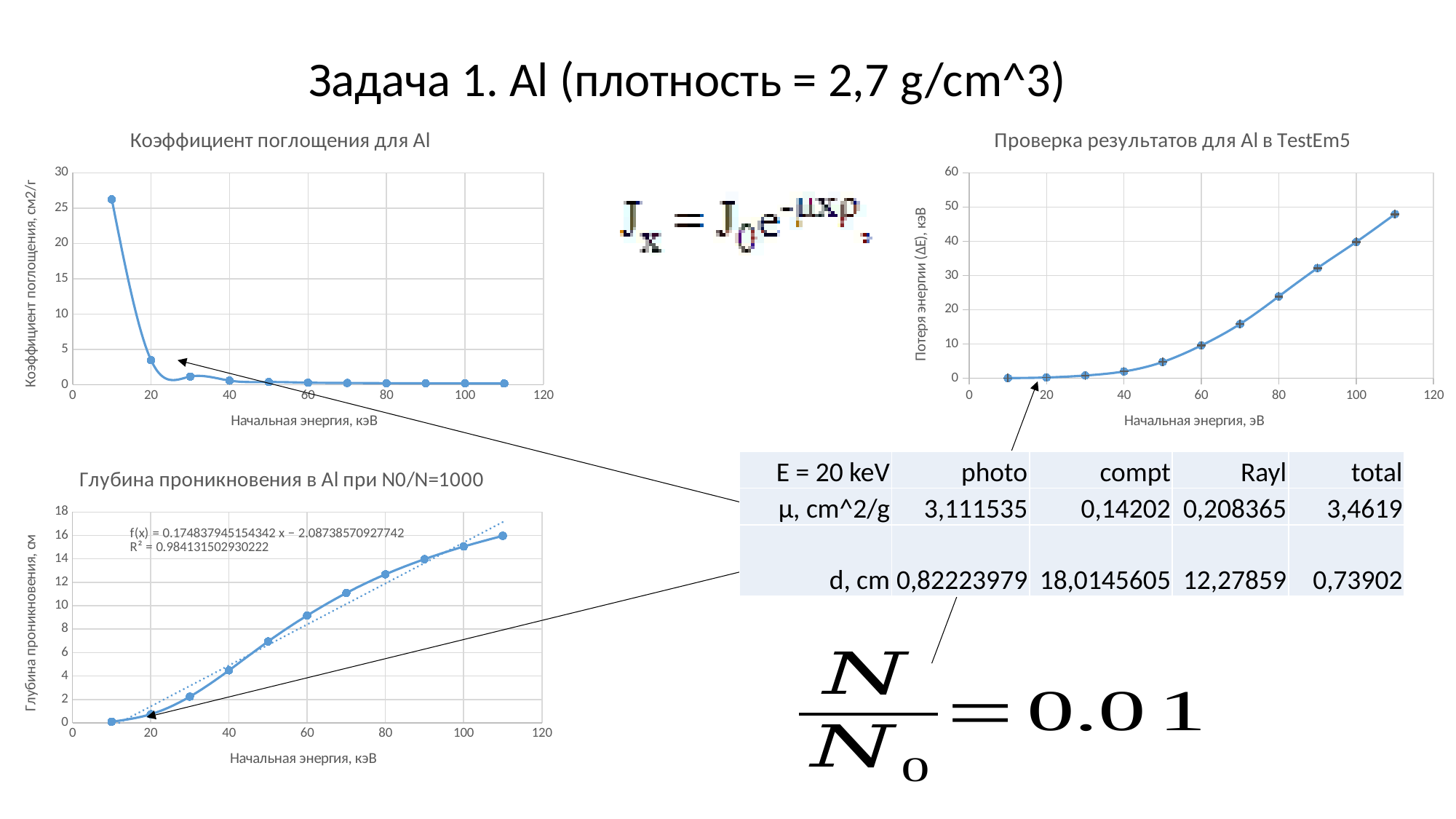
In the chart "Глубина проникновения в Al при N0/N=1000", which is larger: the value at 60 кэВ or the value at 40 кэВ? 60 кэВ How many data points are plotted in the chart "Коэффициент поглощения для Al"? 11 In the chart "Проверка результатов для Al в TestEm5", is the value at 110 greater or less than 40? greater In the chart "Коэффициент поглощения для Al", at which initial energy is the absorption coefficient highest? 10 In the chart "Проверка результатов для Al в TestEm5", do the values rise or fall as the initial energy increases? rise In the chart "Коэффициент поглощения для Al", do the values rise or fall as the initial energy increases? fall In the chart "Глубина проникновения в Al при N0/N=1000", is the value at 110 кэВ greater or less than 14? greater In the chart "Проверка результатов для Al в TestEm5", at which initial energy is the energy loss highest? 110 What kind of chart is "Коэффициент поглощения для Al"? line chart In the chart "Проверка результатов для Al в TestEm5", is the value at 80 greater or less than 20? greater How many data points are plotted in the chart "Глубина проникновения в Al при N0/N=1000"? 11